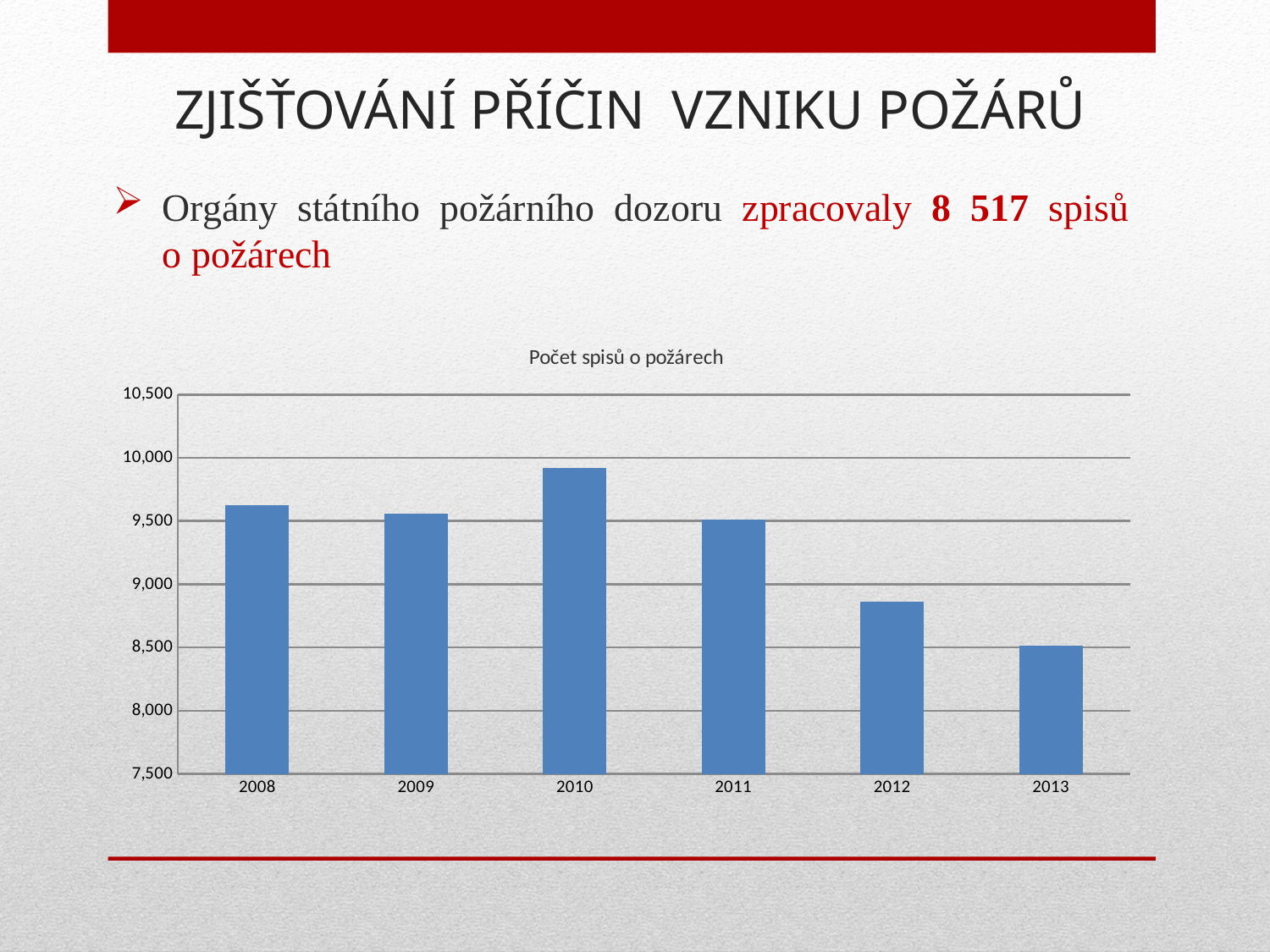
Which is larger, the value for 2008 or the value for 2013? 2008 Which is larger, the value for 2010 or the value for 2012? 2010 Do the values generally rise or fall from 2008 to 2013? fall What is the title of the chart? Počet spisů o požárech Which year has the highest value in the chart? 2010 Is the value for 2012 greater or less than 9,000? less Is the value for 2013 greater or less than 9,000? less How many years are shown on the x axis of the chart? 6 Which year has the lowest value in the chart? 2013 Is the value for 2010 greater or less than 9,500? greater What type of chart is shown on the slide? bar chart